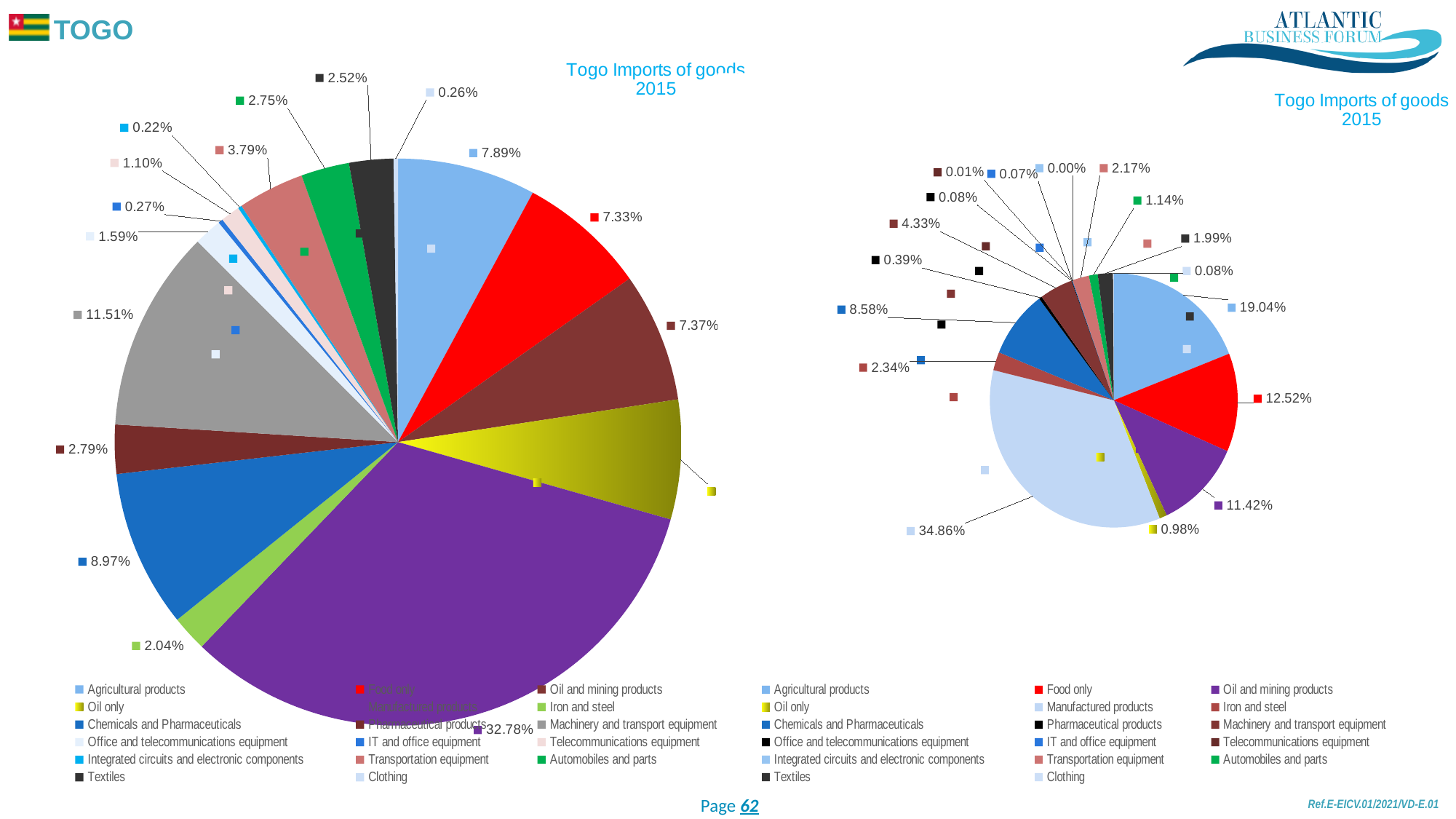
In the right pie chart, what is the share for Food only? 12.52% In the right pie chart, what is the share for Agricultural products? 19.04% In the left pie chart, which is larger: Agricultural products or Iron and steel? Agricultural products In the right pie chart, what is the share for Manufactured products? 34.86% How many categories does the legend of the left pie chart list? 17 In the left pie chart, what is the share for Manufactured products? 32.78% In the left pie chart, which category has the largest share? Manufactured products In the left pie chart, what is the share for Chemicals and Pharmaceuticals? 8.97% What type of charts are shown on the slide? Pie charts In the right pie chart, which category has the largest share? Manufactured products In the right pie chart, what is the difference between the shares for Agricultural products and Food only? 6.52% In the left pie chart, what is the share for Machinery and transport equipment? 11.51%